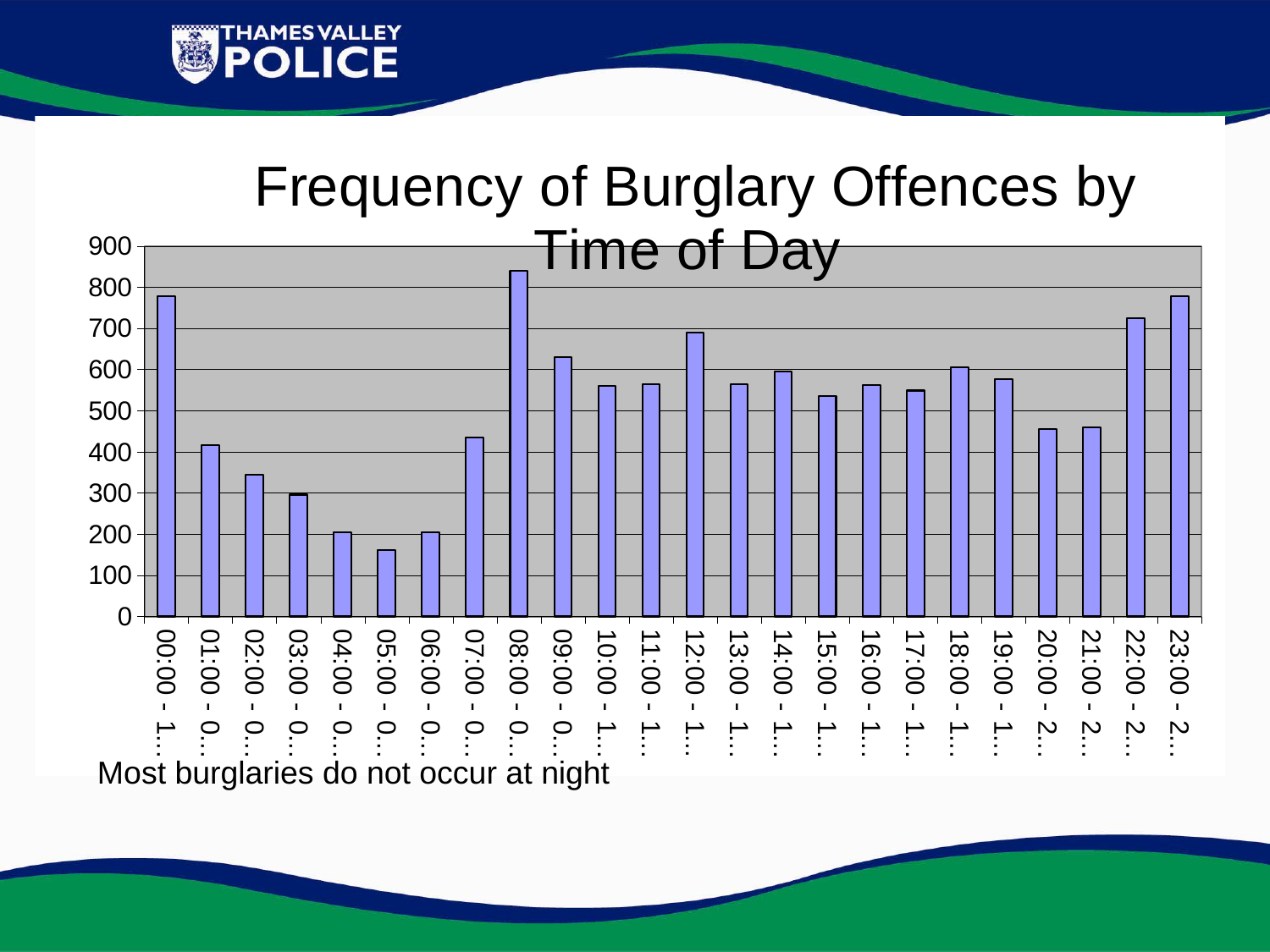
How many time-of-day bars are plotted in the chart? 24 Is the value for the 08:00 bar greater or less than 800? greater Which time-of-day bar has the lowest value? 05:00 Which time-of-day bar has the highest value? 08:00 What kind of chart is shown on the slide? bar chart Which bar is taller, 08:00 or 12:00? 08:00 Is the value for the 05:00 bar greater or less than 200? less Do the values rise or fall from the 00:00 bar to the 05:00 bar? fall Is the value for the 12:00 bar greater or less than 600? greater What is the title of the chart? Frequency of Burglary Offences by Time of Day Which bar is taller, 02:00 or 03:00? 02:00